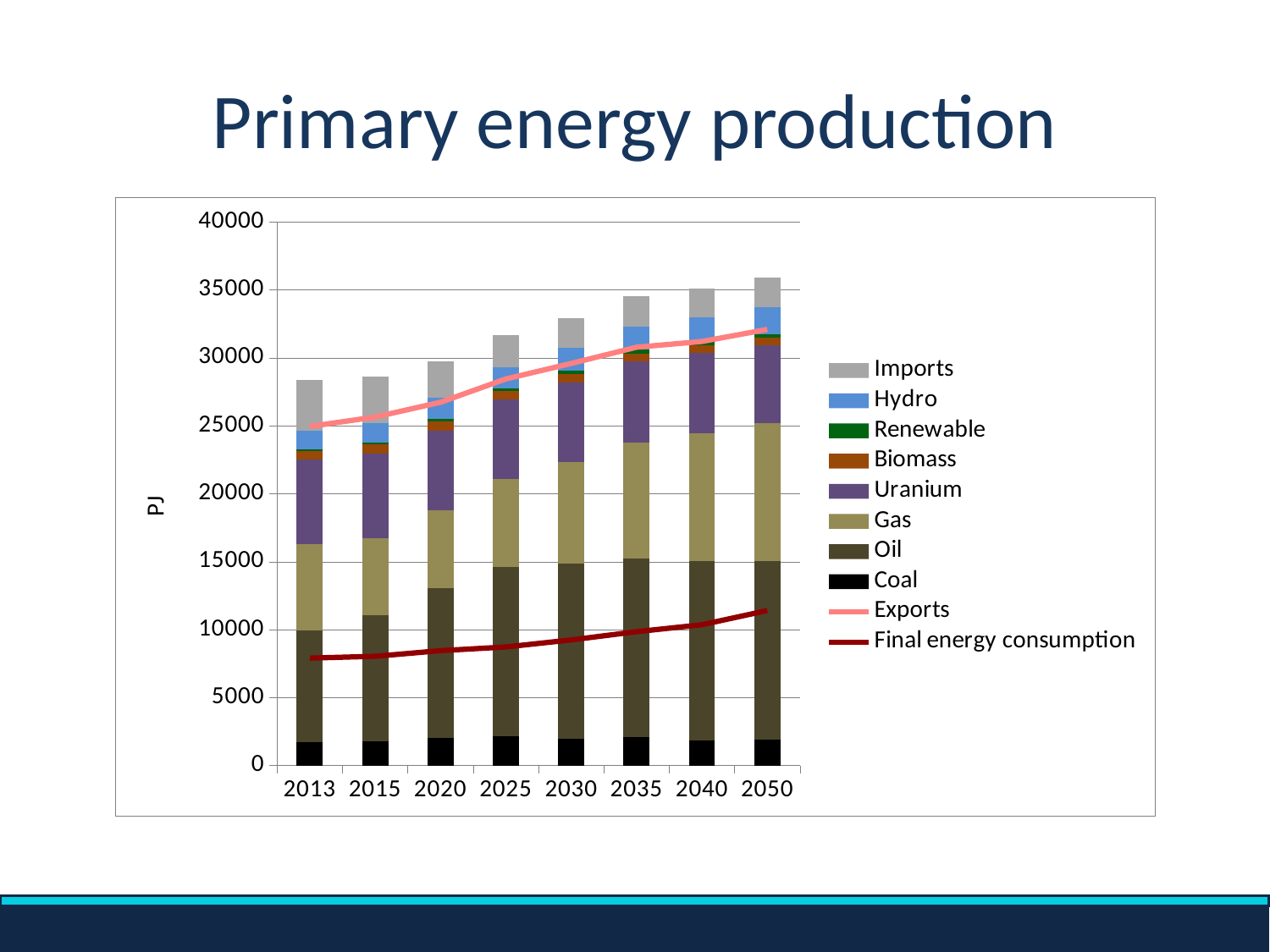
What kind of chart is shown on the slide? stacked bar chart with two line series Is the total stacked bar for 2013 greater or less than 30000? less Is the Final energy consumption value in 2013 greater or less than 10000? less What is the label on the y axis of the chart? PJ In 2050, which is larger: Exports or Final energy consumption? Exports Does the Final energy consumption line rise or fall from 2013 to 2050? rise Is the Final energy consumption value in 2050 greater or less than 10000? greater How many years are shown on the x axis of the chart? 8 How many series does the chart's legend list? 10 Which year has the highest total stacked bar? 2050